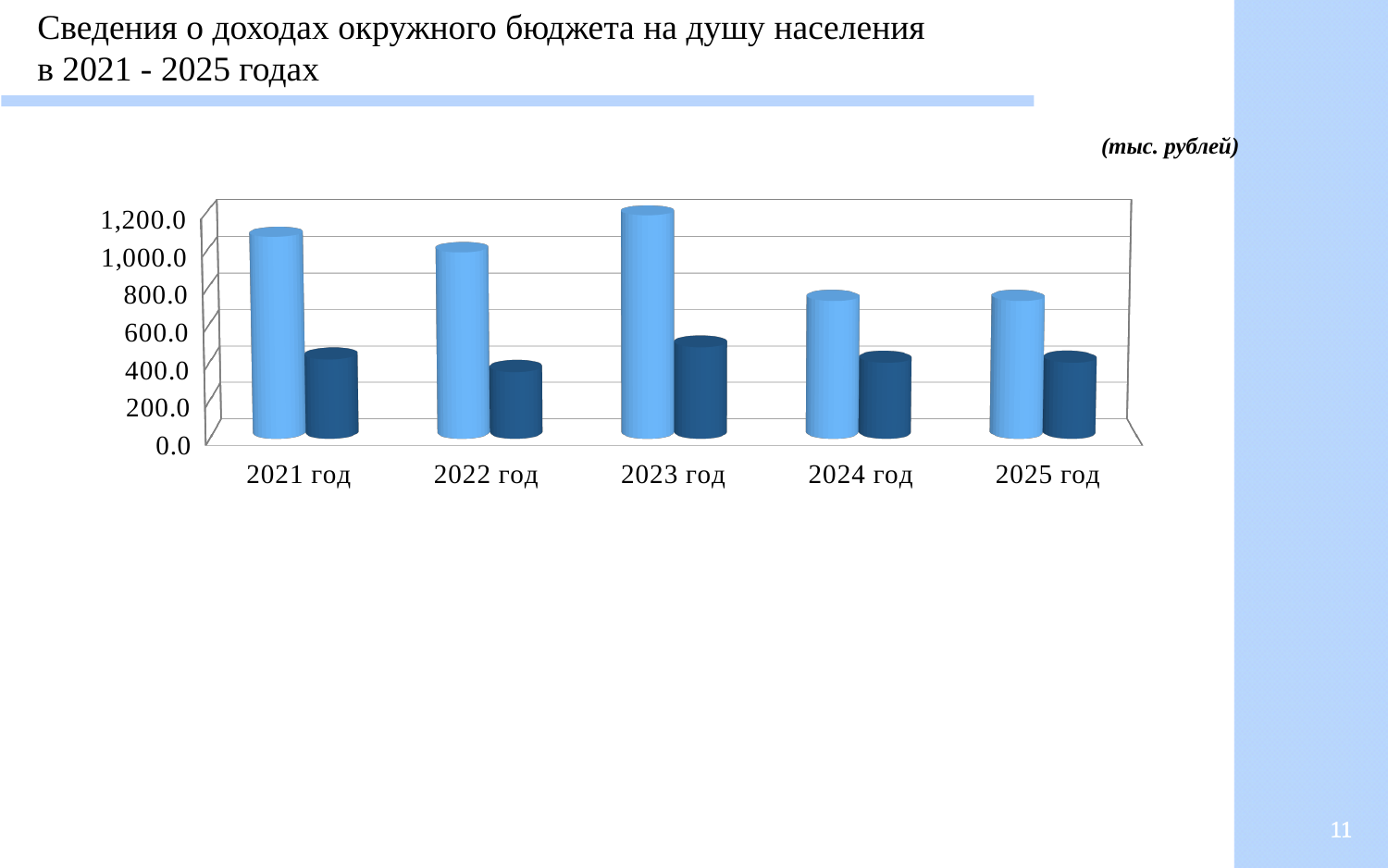
Which year has the tallest light blue bar? 2023 год Is the value of the light blue bar for 2024 год greater or less than 600.0? greater Do the light blue bars rise or fall from 2023 год to 2025 год? fall How many bars are plotted for each year in the chart? 2 Is the value of the dark blue bar for 2022 год greater or less than 600.0? less Is the value of the light blue bar for 2025 год greater or less than 1,000.0? less Which year has the tallest dark blue bar? 2023 год Which is larger: the light blue bar for 2023 год or the light blue bar for 2024 год? 2023 год How many year categories are shown on the x axis of the chart? 5 What kind of chart is shown on the slide? bar chart Is the light blue bar for 2021 год taller than the light blue bar for 2022 год? yes What unit is indicated for the chart values on the slide? тыс. рублей